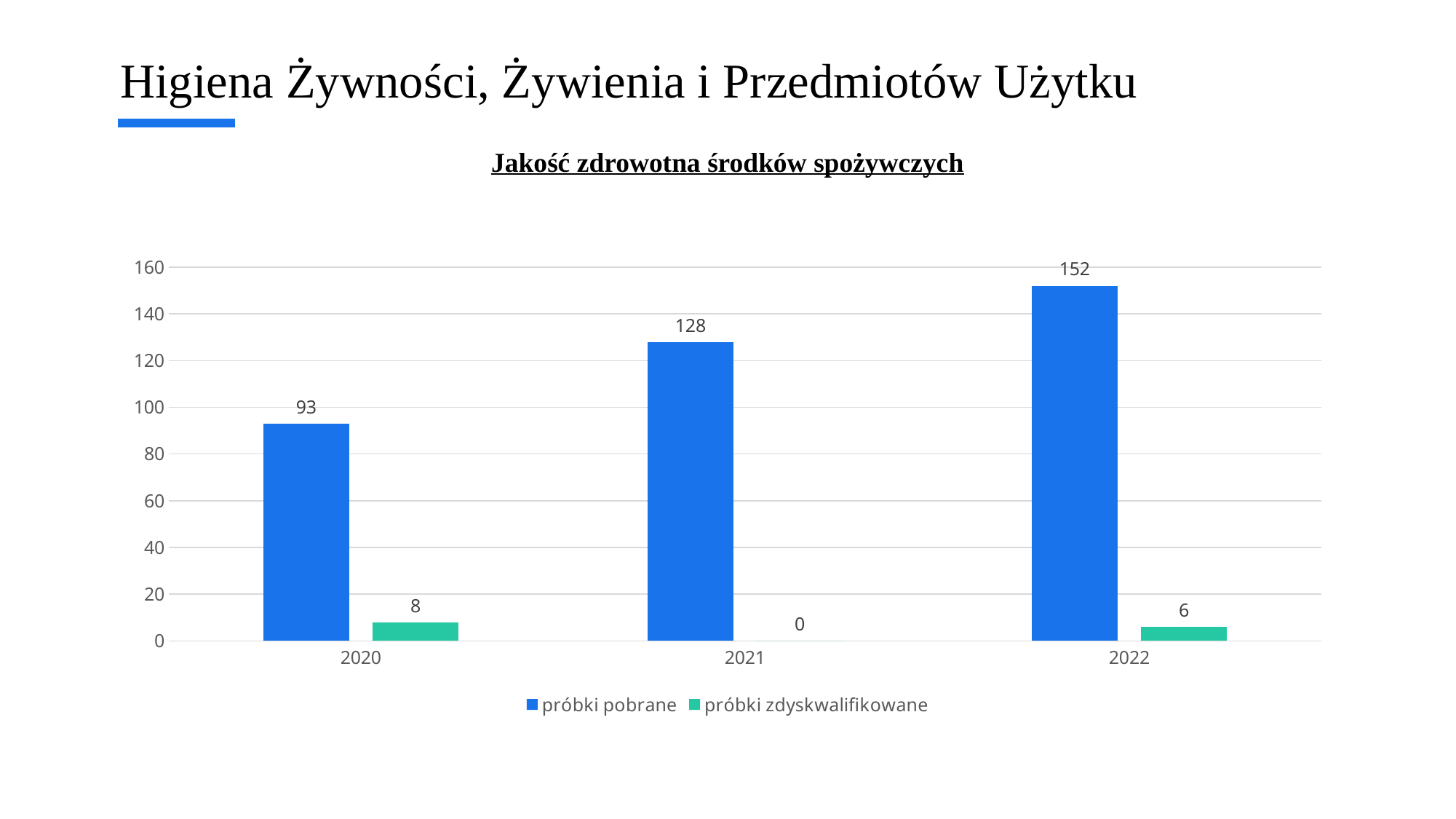
How many series does the legend list? 2 What is the value of próbki zdyskwalifikowane for 2020? 8 Which year has the lowest value for próbki zdyskwalifikowane? 2021 Is the value for próbki pobrane in 2022 greater or less than 140? greater What kind of chart is shown on the slide? bar chart What is the value of próbki pobrane for 2021? 128 Which is larger: próbki pobrane in 2020 or in 2021? 2021 Do the values for próbki pobrane rise or fall from 2020 to 2022? rise What is the difference between próbki pobrane in 2022 and in 2020? 59 What is the value of próbki zdyskwalifikowane for 2022? 6 How many years are shown on the x axis? 3 Which year has the highest value for próbki pobrane? 2022